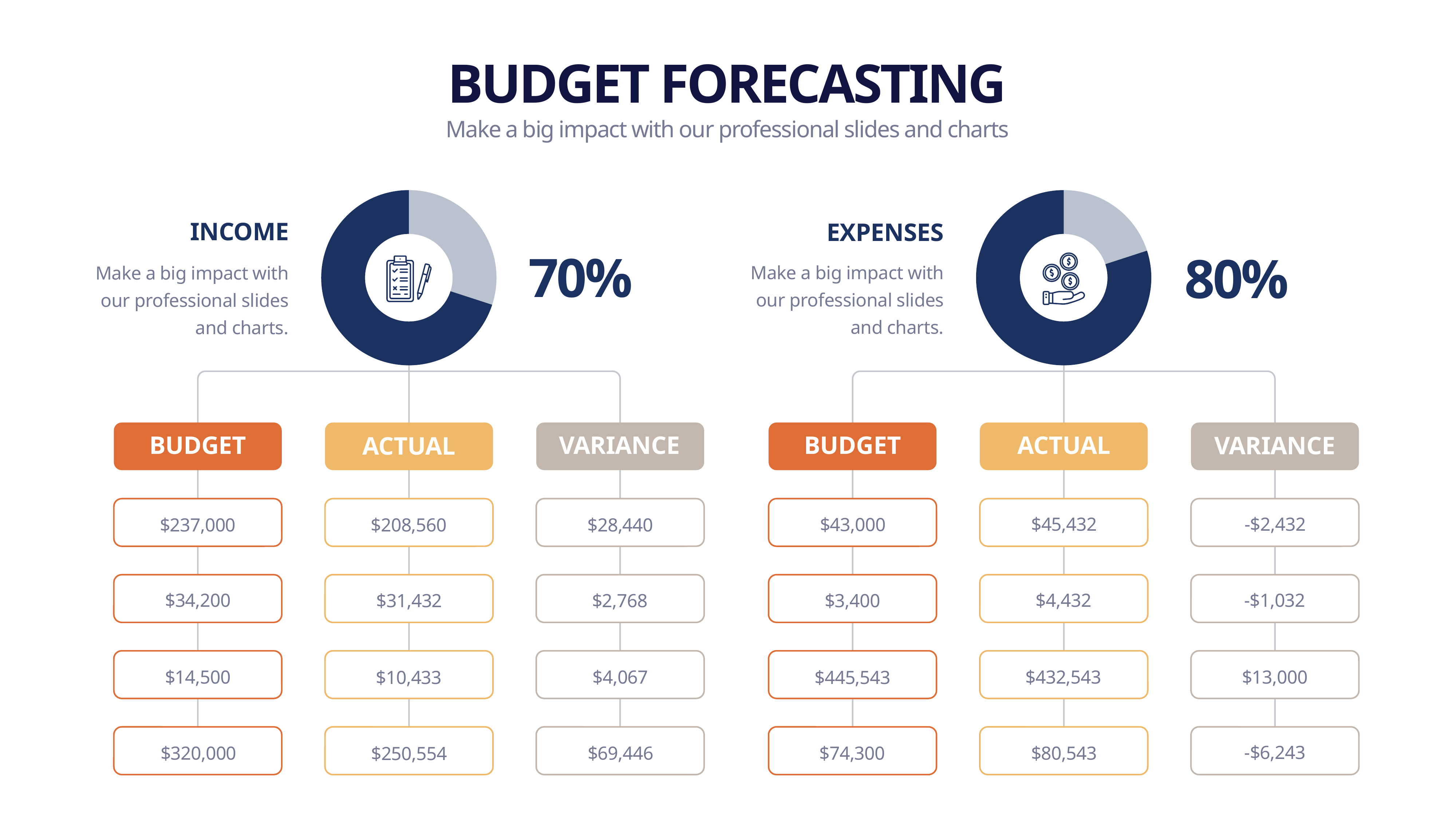
Which donut chart shows the larger percentage, INCOME or EXPENSES? EXPENSES On the EXPENSES donut chart, what share does the light grey segment represent? 20% On the EXPENSES donut chart, what percentage is shown? 80% What is the difference in percentage points between the EXPENSES donut (80%) and the INCOME donut (70%)? 10 percentage points What colour is the segment representing the 80% value on the EXPENSES donut chart? Dark blue On the INCOME donut chart, what percentage is shown? 70% In the INCOME section, what is the first BUDGET value listed below the donut chart? $237,000 What kind of chart is used to show the INCOME and EXPENSES percentages? Donut (pie) chart On the INCOME donut chart, what share does the dark blue segment represent? 70% How many donut charts are on the slide? 2 What is the title of the slide containing the two donut charts? BUDGET FORECASTING In the EXPENSES section, what is the third VARIANCE value listed below the donut chart? $13,000